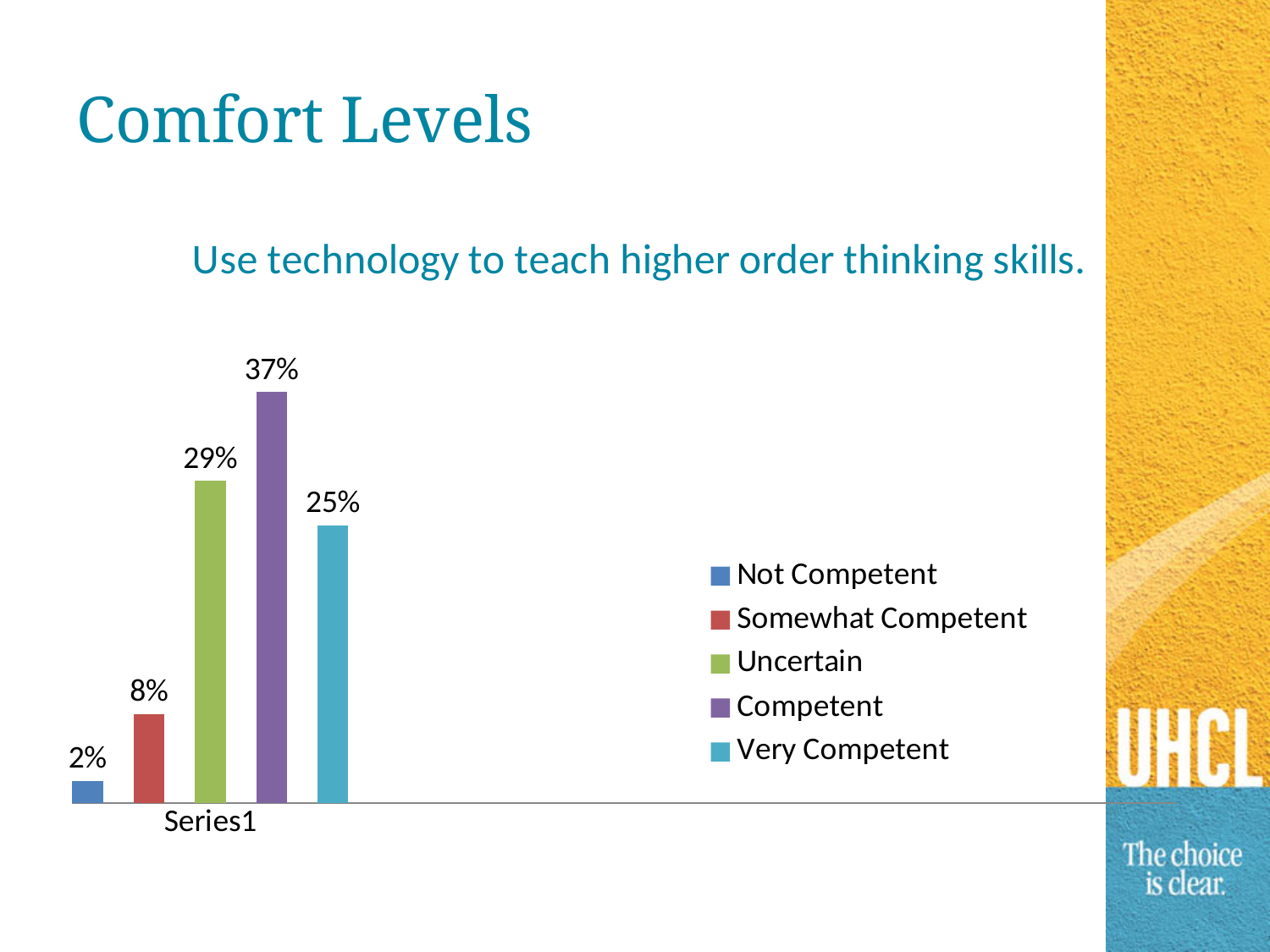
How many comfort levels does the legend list? 5 Which is larger, the value for Uncertain or the value for Very Competent? Uncertain What percentage of respondents reported being Competent at using technology to teach higher order thinking skills? 37% What is the difference between the Somewhat Competent and Not Competent percentages? 6% What kind of chart is shown on the slide? Bar chart What is the value shown for Uncertain? 29% What is the difference between the Competent and Very Competent percentages? 12% What is the value shown for Not Competent? 2% Which comfort level has the lowest percentage? Not Competent Which comfort level has the highest percentage? Competent What colour is the bar for Competent? Purple What is the value shown for Very Competent? 25%